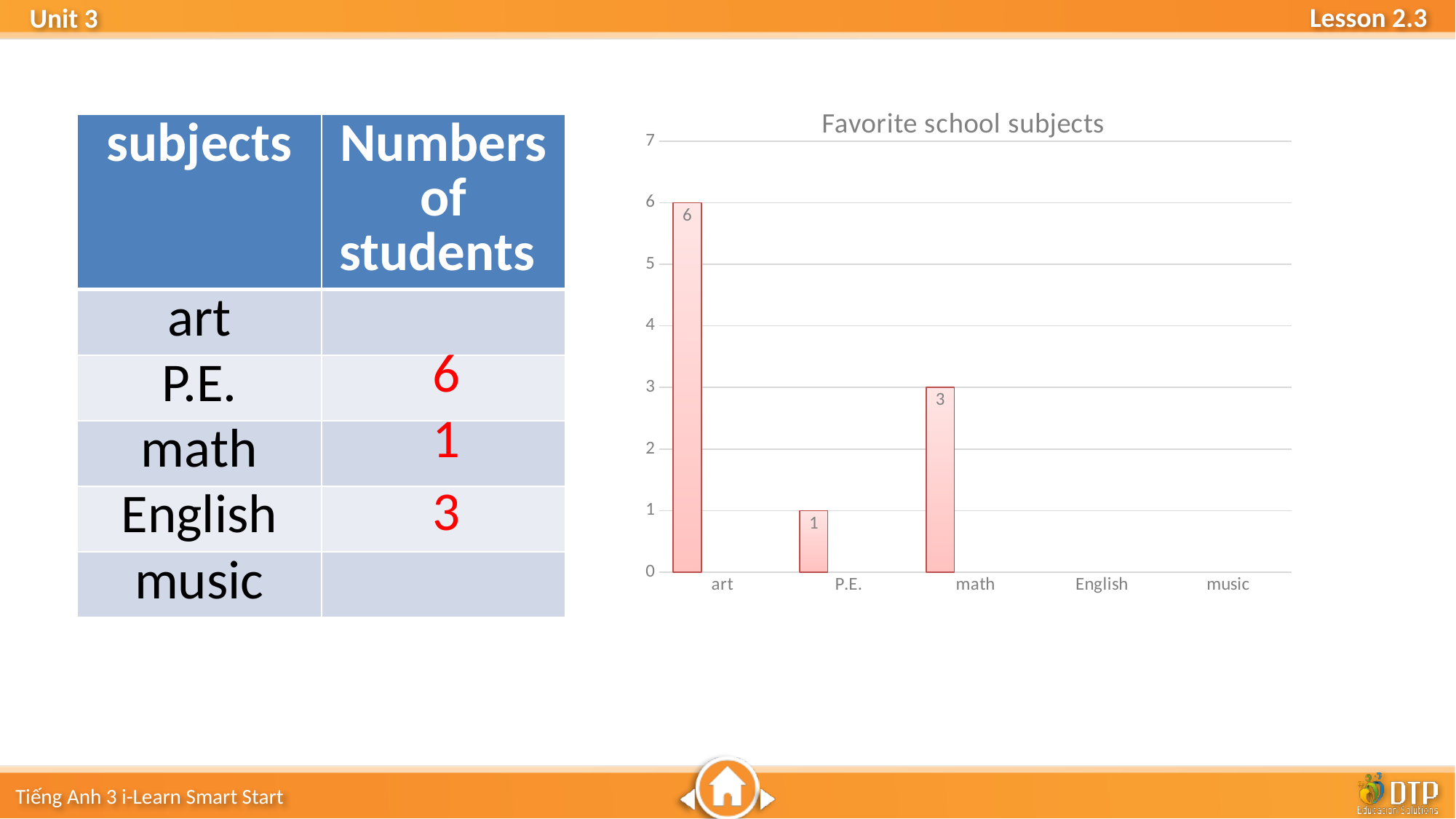
Which has a larger value in the chart, P.E. or math? math What is the value of the bar for math in the chart? 3 What is the value of the bar for art in the chart? 6 What is the difference between the values for math and P.E. in the chart? 2 What is the difference between the values for art and math in the chart? 3 What is the title of the chart? Favorite school subjects What is the value of the bar for P.E. in the chart? 1 Among the subjects with a bar shown, which has the lowest value? P.E. Is the value for art in the chart greater or less than 5? greater How many subject categories are labeled on the x axis of the chart? 5 What type of chart is shown on the slide? bar chart Which subject has the tallest bar in the chart? art